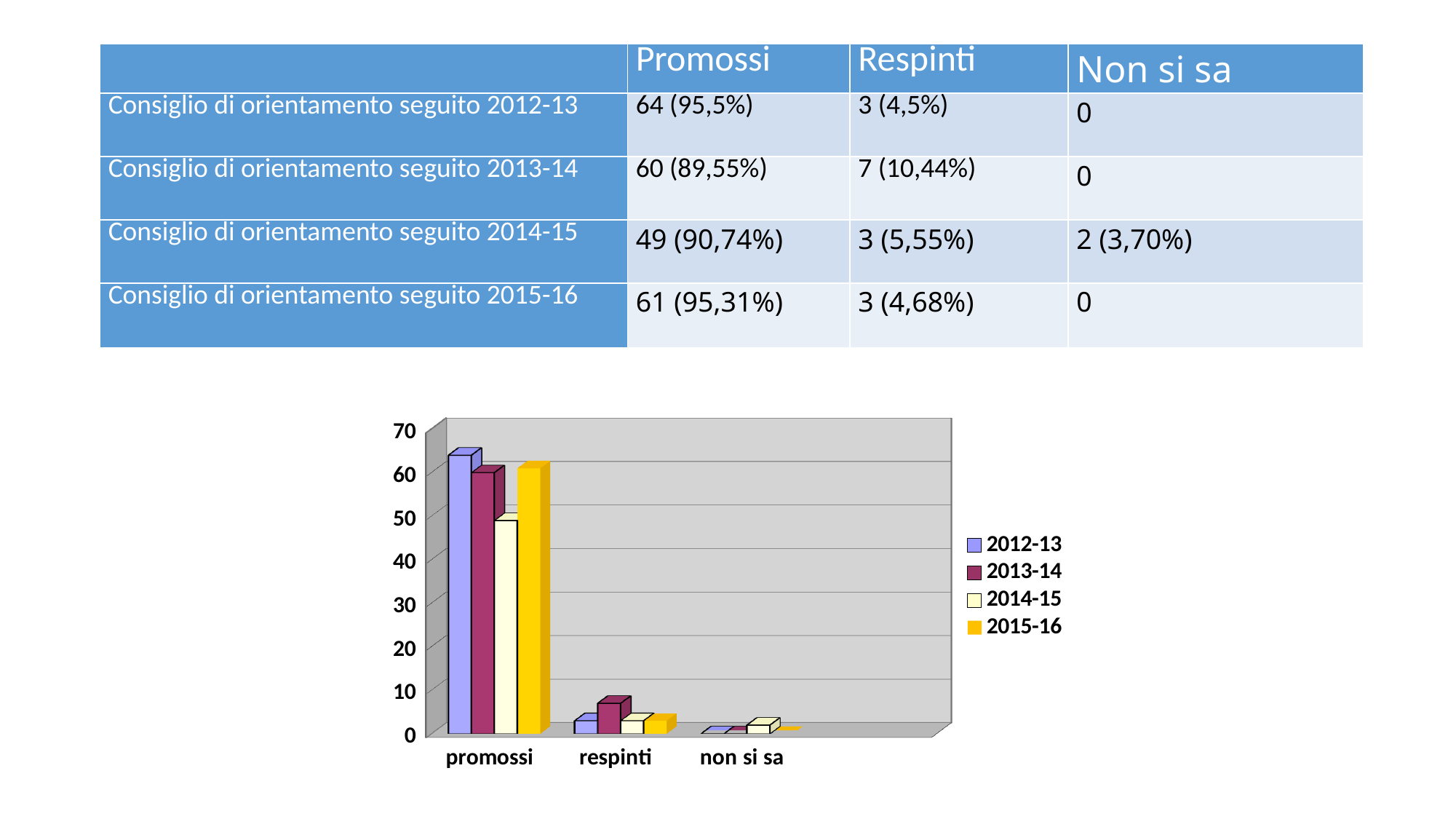
What is the value plotted for 2012-13 in the promossi category? 64 How many series does the chart legend list? 4 What colour is the 2015-16 series in the chart? yellow In the respinti category, which series has the taller bar, 2012-13 or 2013-14? 2013-14 What kind of chart is shown on the slide? bar chart How many categories are shown on the x axis of the chart? 3 Which series has the lowest bar in the promossi category? 2014-15 What is the difference between the promossi values for 2012-13 and 2014-15? 15 Is the value for 2013-14 in the respinti category greater or less than 10? less What is the value plotted for 2014-15 in the non si sa category? 2 Which series has the highest bar in the promossi category? 2012-13 Is the value for 2015-16 in the promossi category greater or less than 50? greater